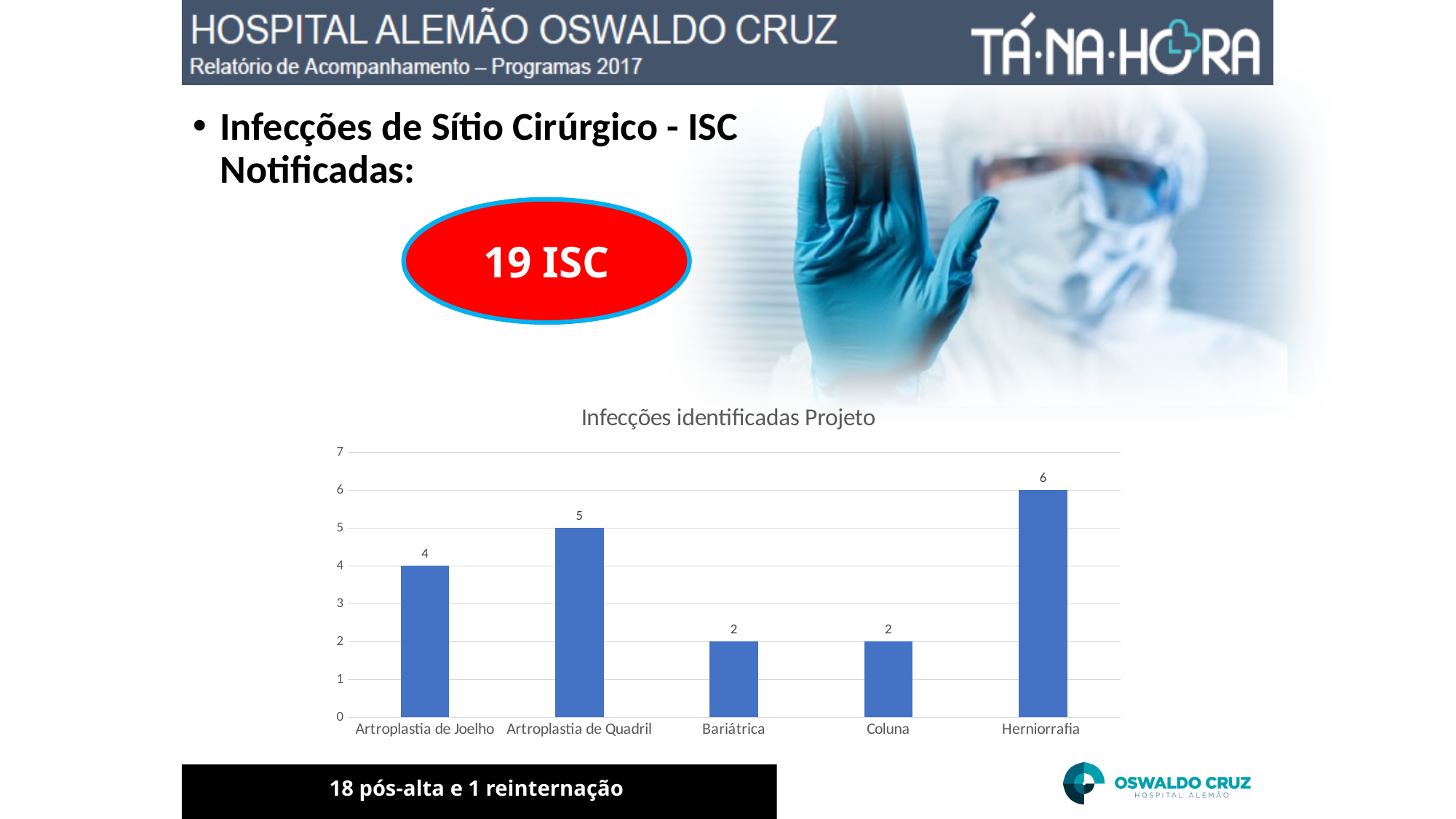
What is the difference between the values for Herniorrafia and Artroplastia de Joelho? 2 What is the value for Herniorrafia? 6 How many categories are shown on the x axis? 5 What is the title of the chart? Infecções identificadas Projeto What is the value for Artroplastia de Joelho? 4 What is the value for Artroplastia de Quadril? 5 What is the value for Bariátrica? 2 What kind of chart is shown on the slide? bar chart Which is larger, the value for Artroplastia de Quadril or the value for Coluna? Artroplastia de Quadril Is the value for Herniorrafia greater or less than 5? greater Which category has the highest value? Herniorrafia What is the difference between the values for Artroplastia de Quadril and Bariátrica? 3